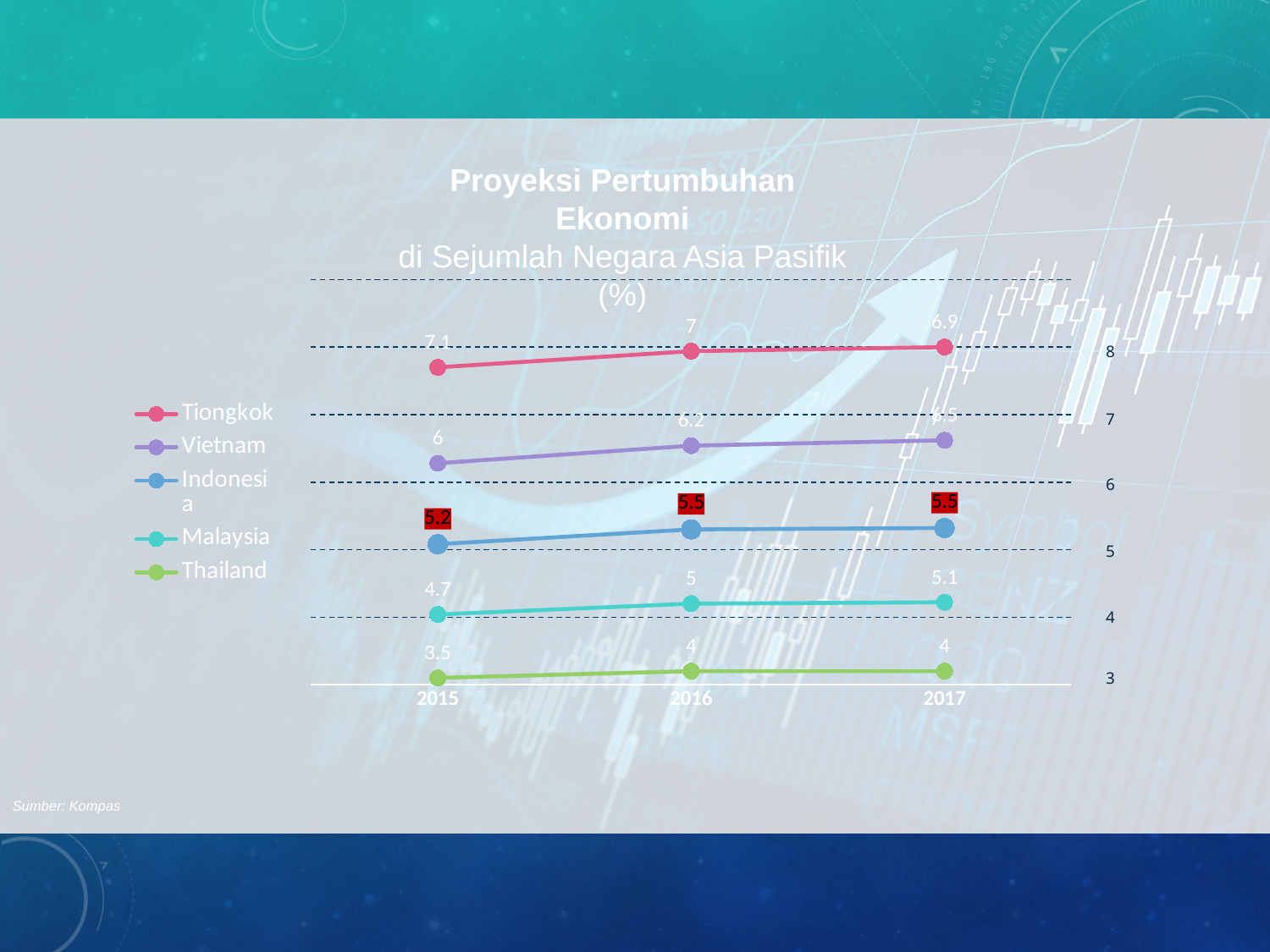
What kind of chart is shown on the slide? Line chart Which country has the lowest value in 2017? Thailand What is the projected growth value for Indonesia in 2015? 5.2 How many years are shown on the x axis? 3 What is the difference between Vietnam's value in 2017 and its value in 2015? 0.5 What is the value for Vietnam in 2016? 6.2 Which is larger in 2017: the value for Malaysia or the value for Indonesia? Indonesia Does the value for Tiongkok rise or fall from 2015 to 2017? Fall What is the value for Tiongkok in 2017? 6.9 How many series does the legend list? 5 What is the value for Thailand in 2015? 3.5 Which country has the highest value in 2016? Tiongkok